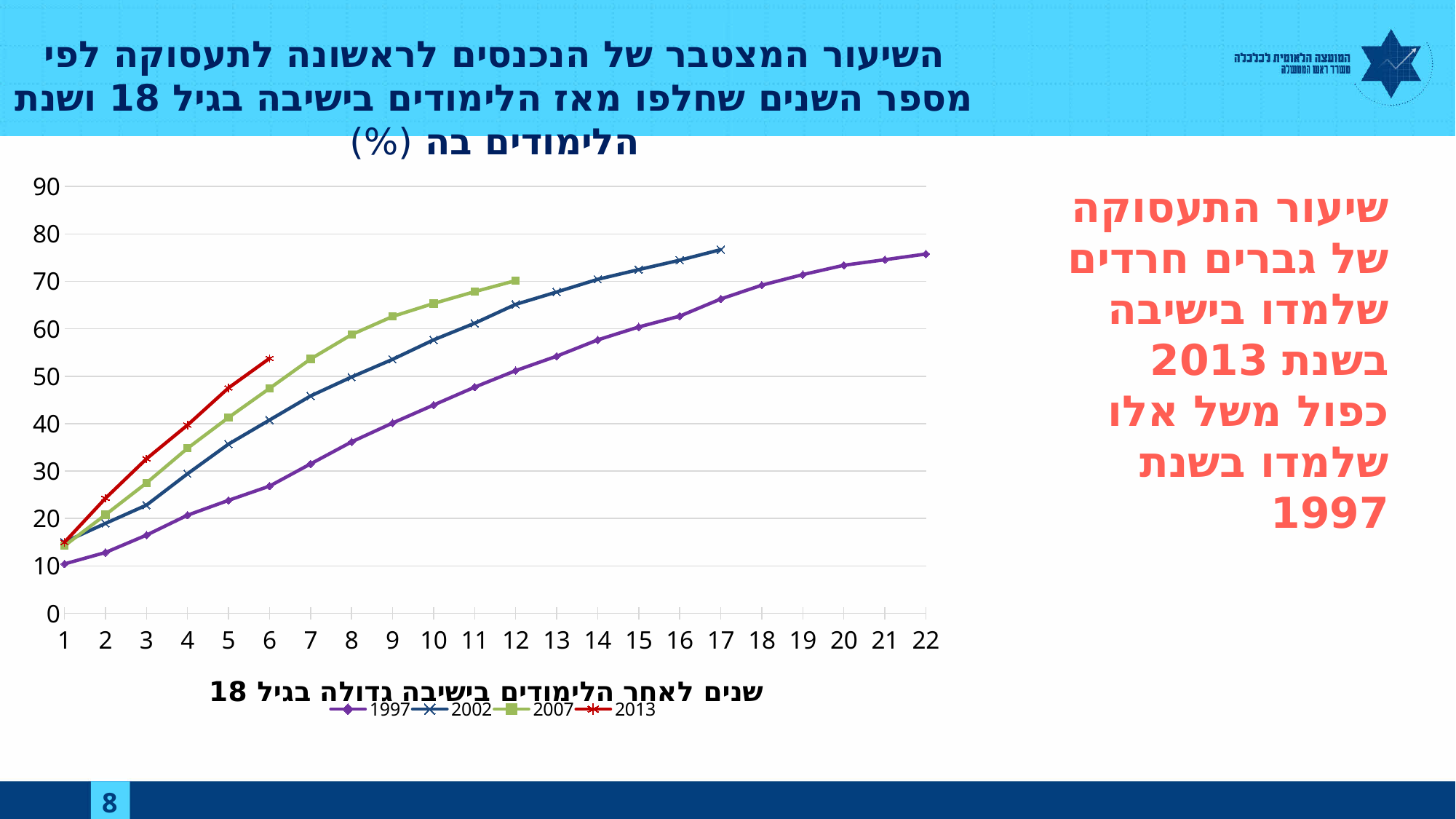
What kind of chart is shown on the slide? line chart How many series does the legend list? 4 Do the values of the 1997 series rise or fall as the number of years increases along the x axis? rise Is the value for the 2002 series at year 17 greater or less than 70? greater Which series extends to the largest number of years on the x axis? 1997 Is the value for the 1997 series at year 1 greater or less than 20? less Is the value for the 2013 series at year 6 greater or less than 50? greater What are the series names listed in the legend? 1997, 2002, 2007, 2013 How many points are labelled on the x axis? 22 At year 6, which series has the higher value, 2013 or 1997? 2013 At year 5, which series has the highest value? 2013